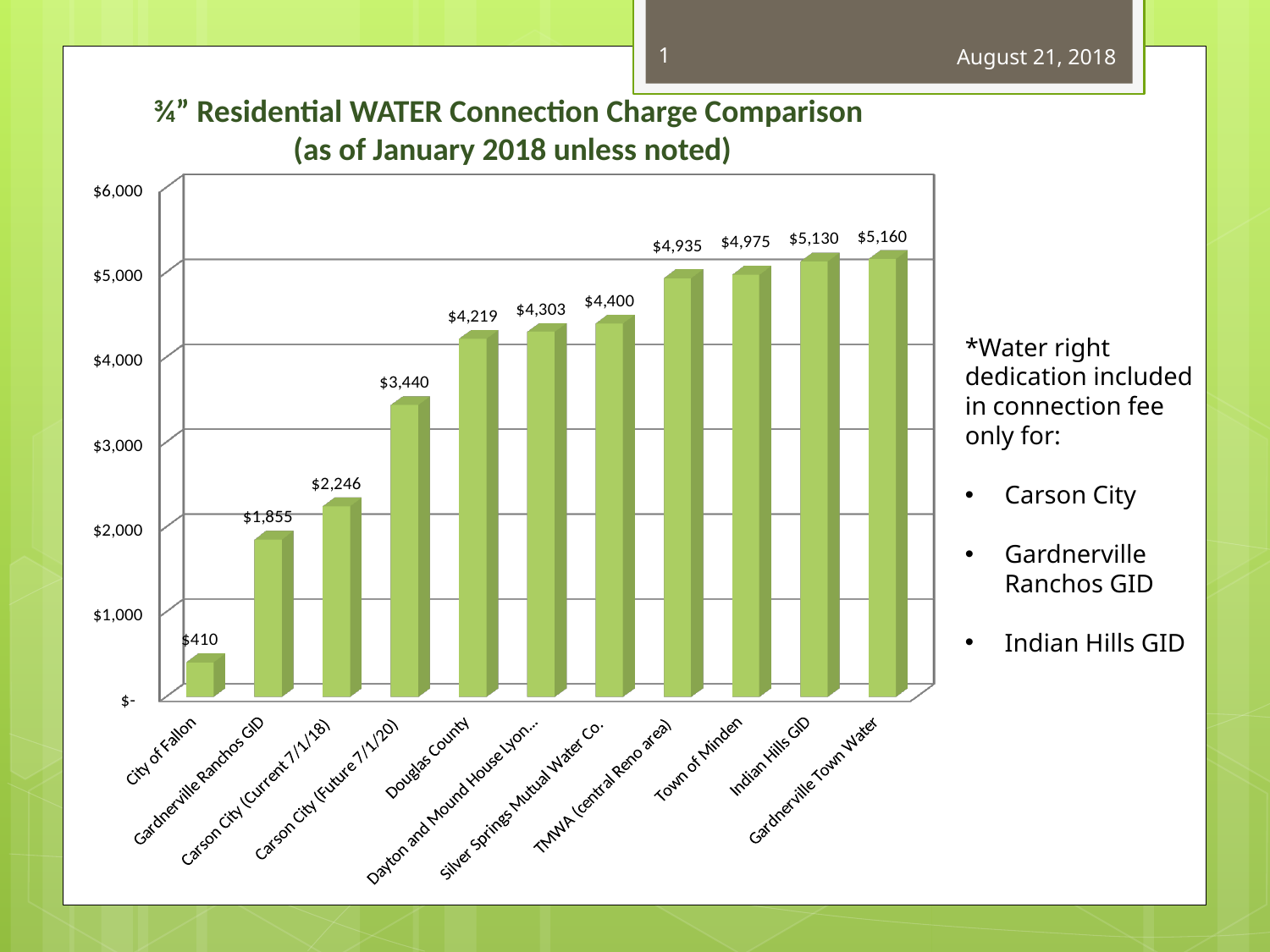
How many categories are shown in the chart? 11 What is the difference between the connection charges for Carson City (Future 7/1/20) and Carson City (Current 7/1/18)? $1,194 Which category has the highest connection charge? Gardnerville Town Water What kind of chart is shown on the slide? bar chart Which has a higher connection charge, Indian Hills GID or TMWA (central Reno area)? Indian Hills GID What is the title of the chart? ¾" Residential WATER Connection Charge Comparison (as of January 2018 unless noted) What is the connection charge for Town of Minden? $4,975 What is the connection charge for Douglas County? $4,219 Which category has the lowest connection charge? City of Fallon What is the connection charge for Carson City (Future 7/1/20)? $3,440 Do the connection charges rise or fall from left to right along the x axis? rise Is the connection charge for Gardnerville Ranchos GID greater or less than $2,000? less